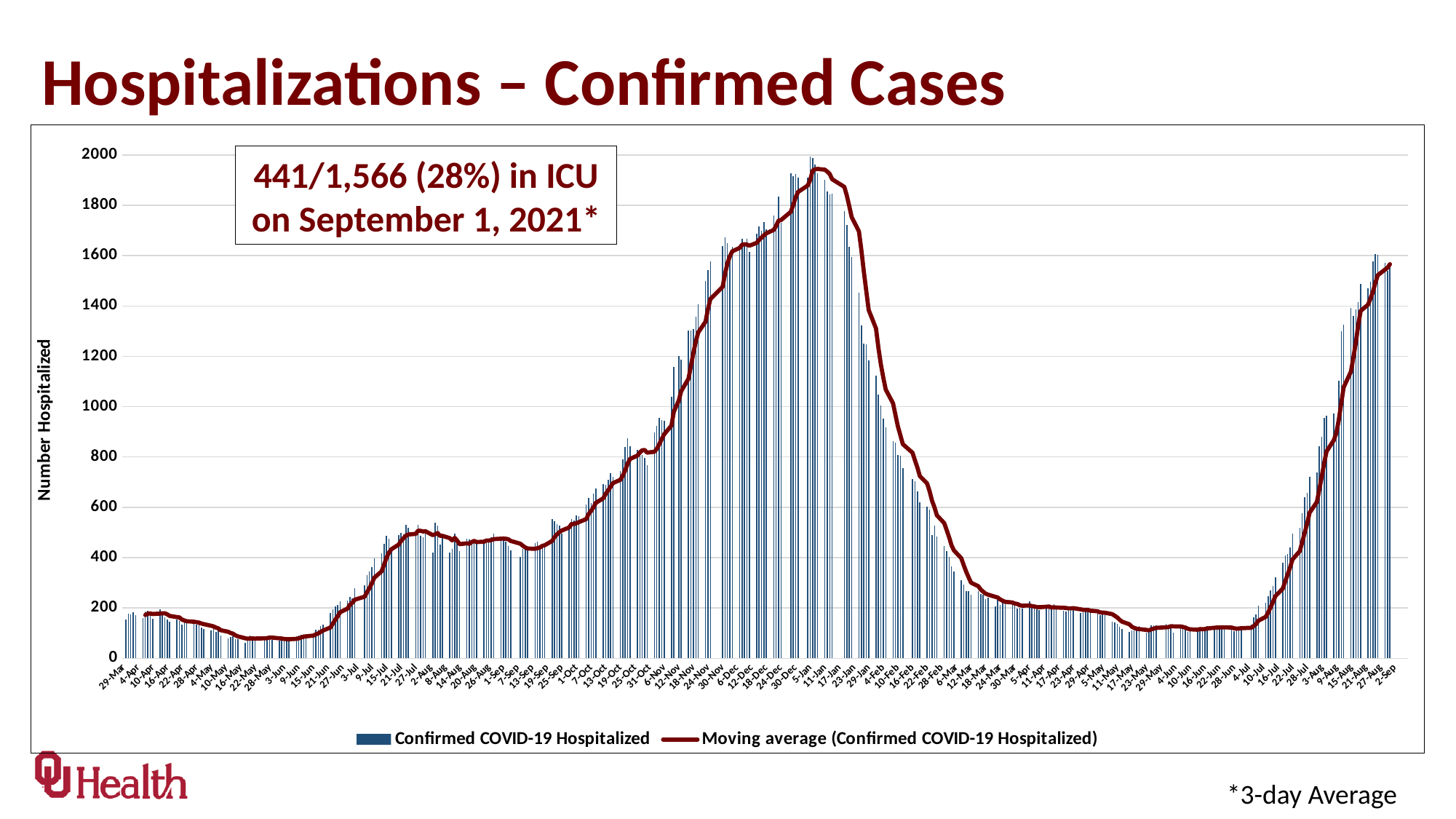
What kind of chart is shown on the slide? A bar chart with a moving-average line In which month does the number hospitalized reach its highest point on the chart? January According to the text box on the chart, how many confirmed cases were hospitalized on September 1, 2021? 1,566 How many series does the legend list? 2 What is the title of the y axis? Number Hospitalized Is the moving average of confirmed hospitalizations at 2-Sep greater or less than 1400? greater According to the text box on the chart, how many hospitalized confirmed cases were in ICU on September 1, 2021? 441 Is the moving average of confirmed hospitalizations around 22-May (the first May shown) greater or less than 200? less Is the moving average of confirmed hospitalizations around 5-Jan greater or less than 1800? greater What does the dark red line in the chart represent, according to the legend? Moving average (Confirmed COVID-19 Hospitalized) Does the moving average rise or fall between 17-Jan and 24-Mar? fall According to the text box on the chart, what percentage of hospitalized confirmed cases were in ICU on September 1, 2021? 28%